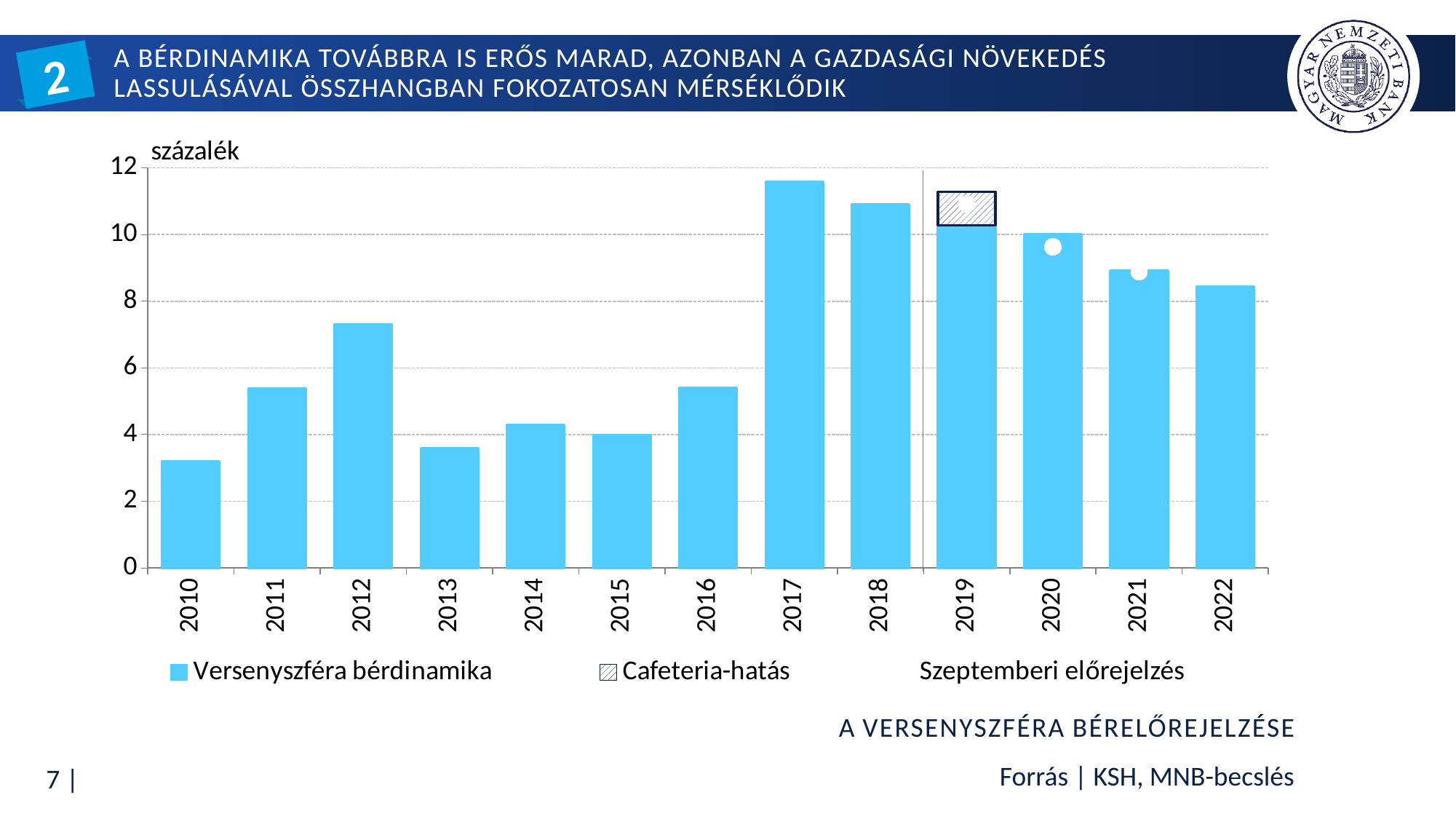
How many years are shown on the x axis of the chart? 13 What kind of chart is shown on the slide? bar chart Which year has the highest Versenyszféra bérdinamika bar? 2017 How many entries does the chart legend list? 3 Which year has the lowest Versenyszféra bérdinamika bar? 2010 Is the Versenyszféra bérdinamika value for 2022 greater or less than 10? less Is the Versenyszféra bérdinamika value for 2010 greater or less than 4? less Do the Versenyszféra bérdinamika bars rise or fall from 2019 to 2022? fall Is the Versenyszféra bérdinamika value for 2017 greater or less than 10? greater What unit label is shown above the vertical axis of the chart? százalék Which year has the larger Versenyszféra bérdinamika bar, 2012 or 2013? 2012